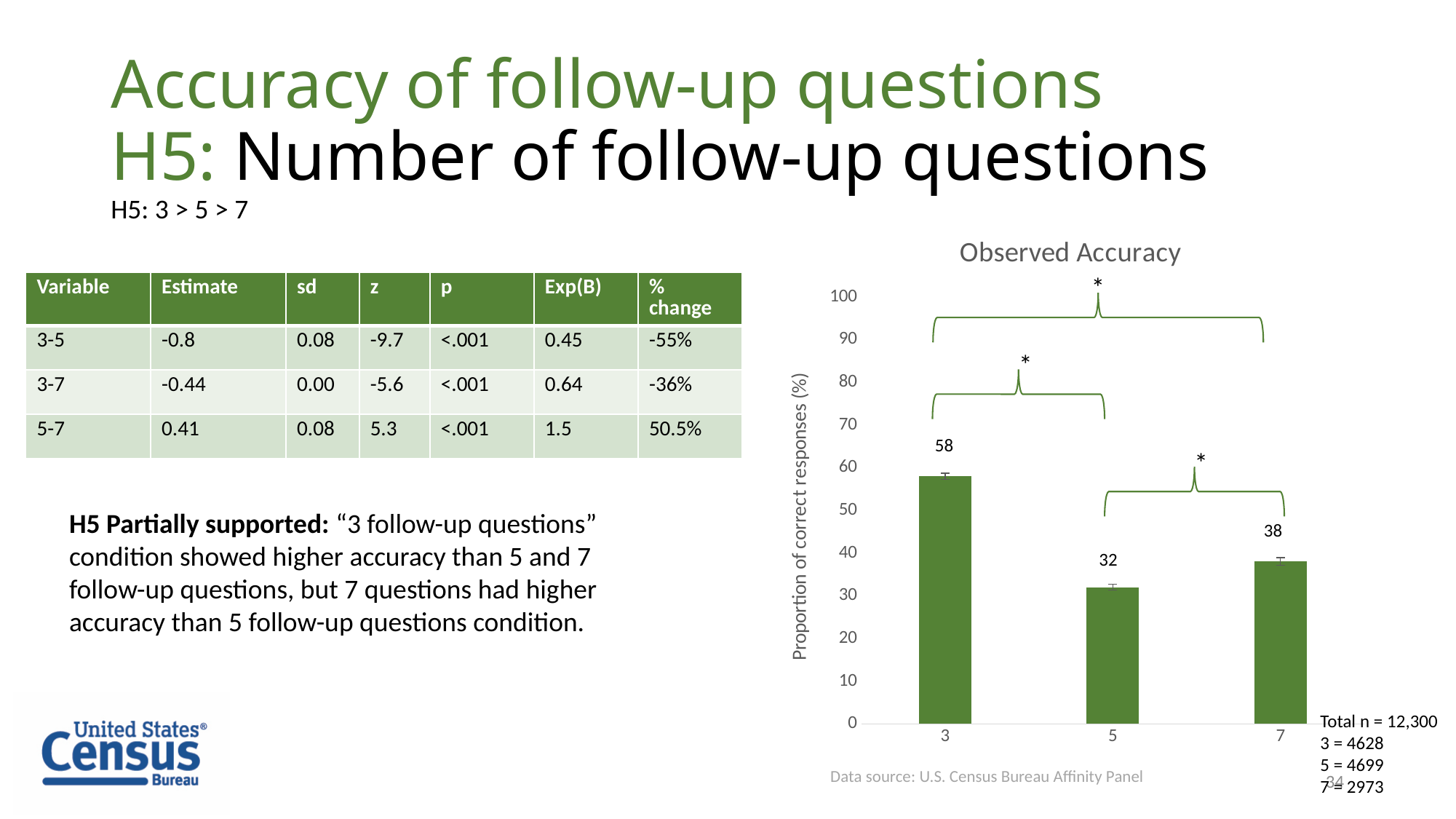
What is the observed accuracy value for the 5 follow-up questions condition? 32 What type of chart is used to show Observed Accuracy? bar chart How many conditions (bars) are shown in the Observed Accuracy chart? 3 What is the difference in observed accuracy between the 7 and 5 follow-up questions conditions? 6 Is the observed accuracy for the 3 follow-up questions condition greater or less than 50? greater Which condition has the lowest observed accuracy? 5 What is the title of the chart on the slide? Observed Accuracy What is the difference in observed accuracy between the 3 and 5 follow-up questions conditions? 26 Which condition has the highest observed accuracy? 3 What is the observed accuracy value for the 7 follow-up questions condition? 38 Which has higher observed accuracy, the 5 or the 7 follow-up questions condition? 7 What is the observed accuracy value for the 3 follow-up questions condition? 58